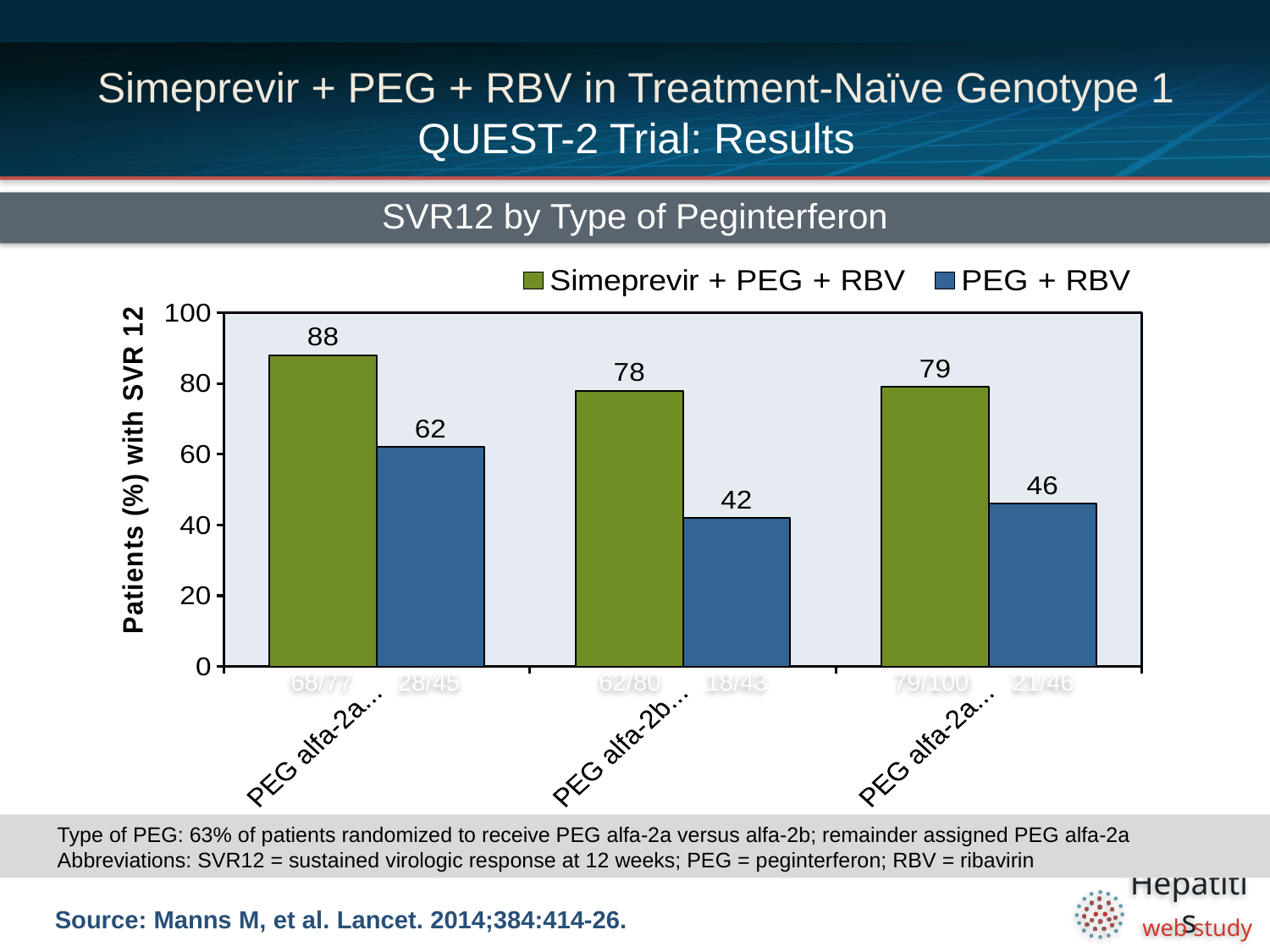
Which category has the lowest PEG + RBV value? PEG alfa-2b How many series does the legend list? 2 What is the SVR12 value for PEG + RBV in the PEG alfa-2b category? 42 What kind of chart is shown on the slide? Bar chart What is the title of the chart? SVR12 by Type of Peginterferon What is the SVR12 value for Simeprevir + PEG + RBV in the PEG alfa-2b category? 78 Which is larger: the PEG + RBV value in the first group or the PEG + RBV value in the third group? The first group (62) What is the SVR12 value for Simeprevir + PEG + RBV in the first (leftmost) category group? 88 Which category group has the highest Simeprevir + PEG + RBV value? The first (leftmost) group, PEG alfa-2a What is the SVR12 value for PEG + RBV in the third (rightmost) category group? 46 What is the difference between the Simeprevir + PEG + RBV and PEG + RBV values in the first (leftmost) category group? 26 What is the difference between the Simeprevir + PEG + RBV and PEG + RBV values in the PEG alfa-2b category? 36